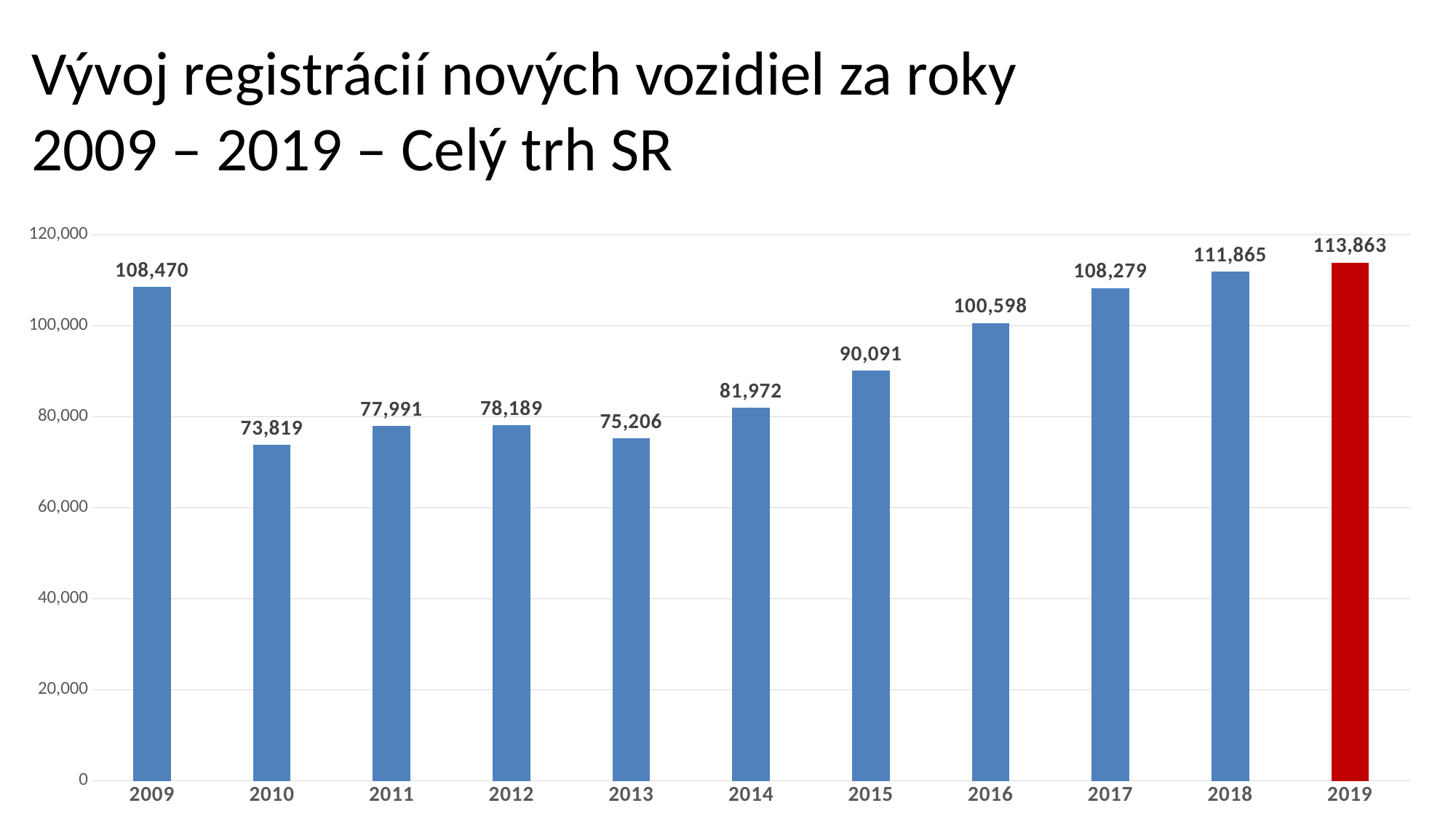
What is the value for 2009? 108,470 What is the value for 2015? 90,091 Which bar is coloured red instead of blue? 2019 Is the value for 2016 greater or less than 100,000? greater What is the difference between the values for 2009 and 2010? 34,651 Which is larger, the value for 2011 or the value for 2012? 2012 What is the value for 2019? 113,863 How many years are shown on the x axis? 11 What is the difference between the values for 2019 and 2018? 1,998 What kind of chart is shown on the slide? bar chart Which year has the lowest value? 2010 Which year has the highest value? 2019